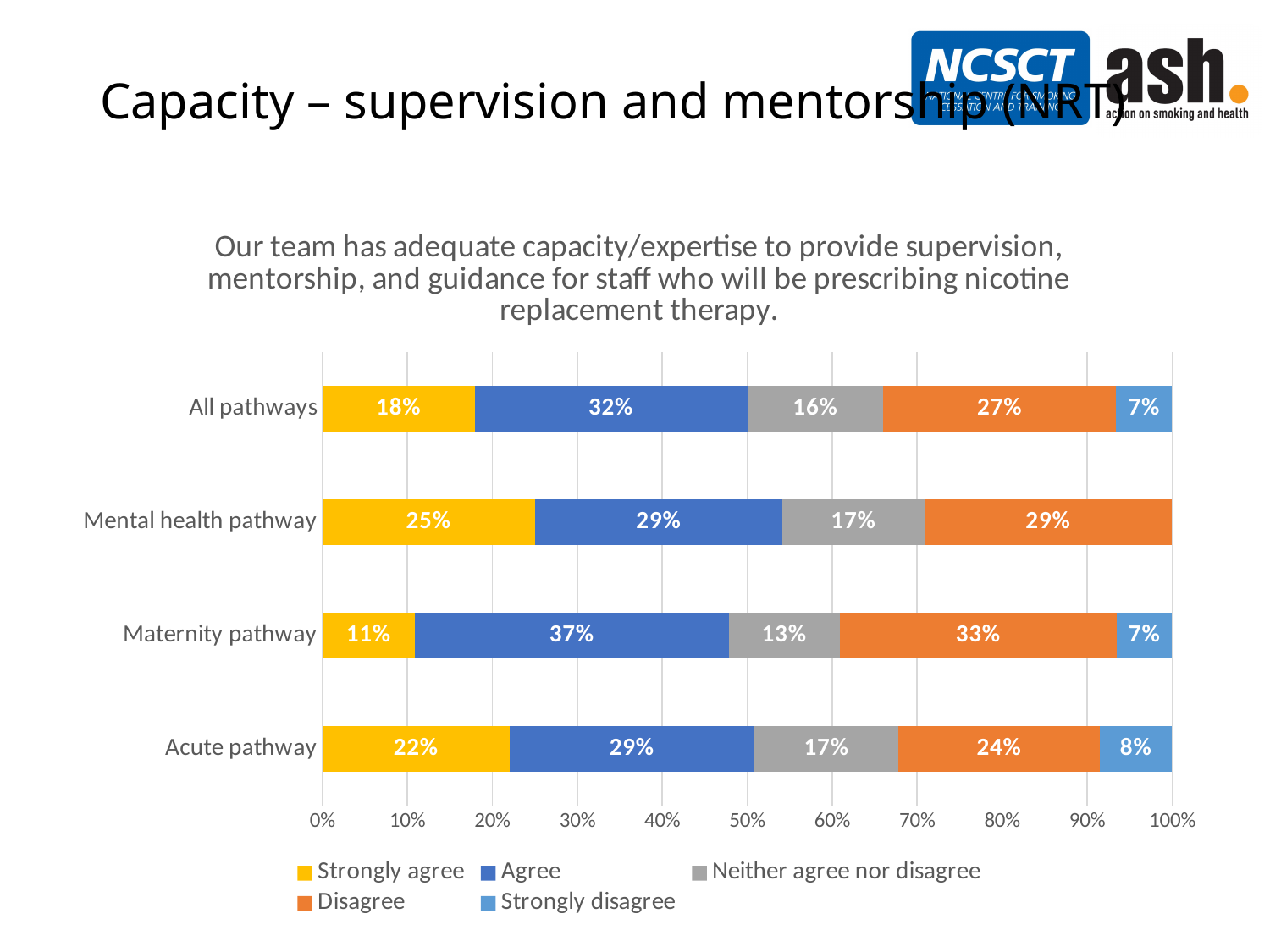
What percentage of respondents in the Maternity pathway selected 'Agree'? 37% What percentage of respondents in the Mental health pathway selected 'Neither agree nor disagree'? 17% What type of chart is shown on the slide? Stacked bar chart Which legend entry is shown in yellow? Strongly agree What is the difference between the 'Disagree' percentages for the Maternity pathway and the Acute pathway? 9% What percentage of respondents in the Acute pathway selected 'Strongly agree'? 22% What percentage of respondents across All pathways selected 'Disagree'? 27% How many series does the legend list? 5 How many pathway categories are shown on the chart? 4 Which pathway has the highest 'Strongly agree' percentage? Mental health pathway Which is larger: the 'Agree' percentage for All pathways or for the Acute pathway? All pathways Which pathway has the lowest 'Strongly agree' percentage? Maternity pathway